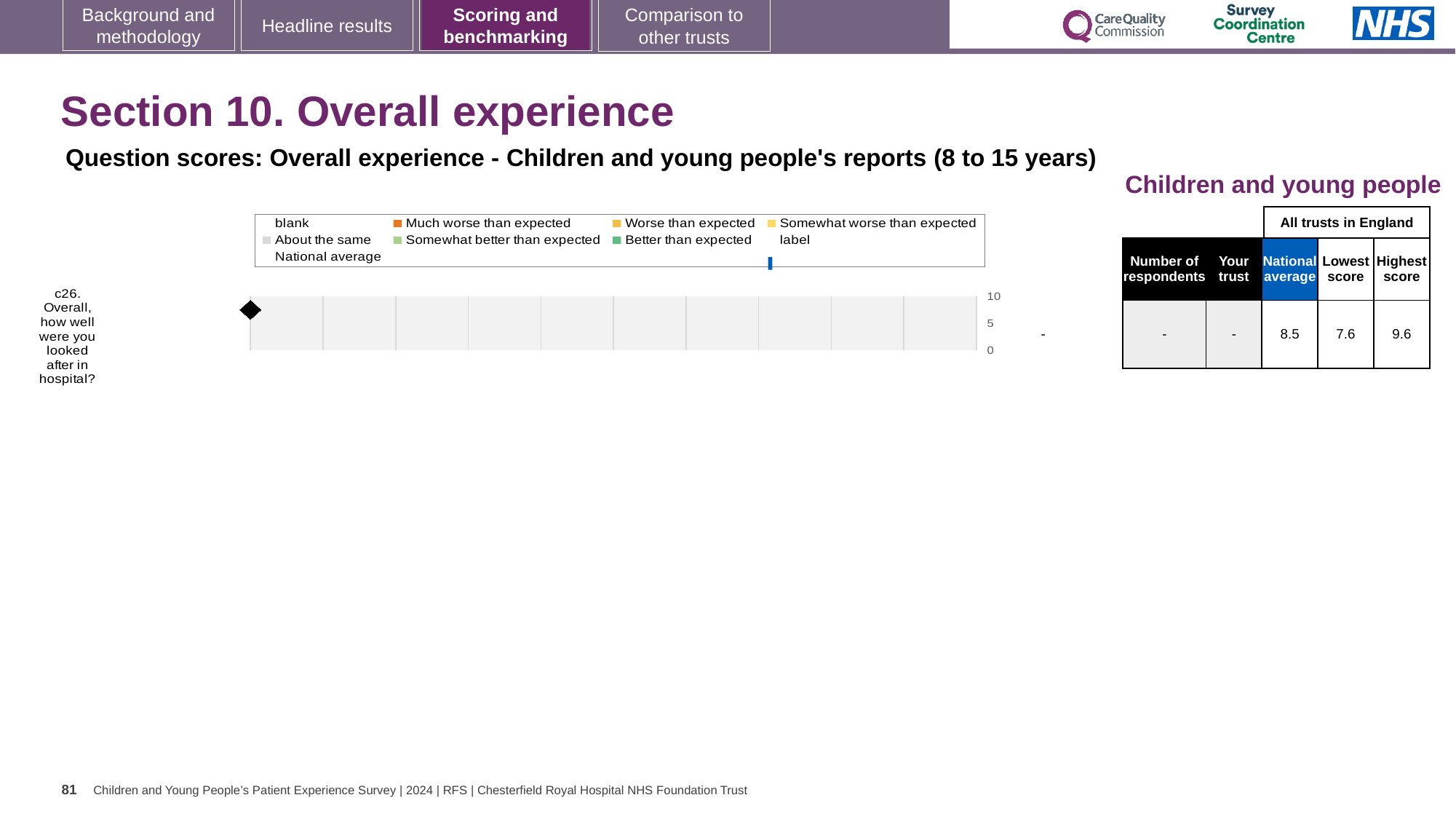
How many survey questions are plotted on the chart? 1 What is the question label shown on the chart? c26. Overall, how well were you looked after in hospital? In the table next to the chart, what value is shown for 'Your trust' for c26? - In the table next to the chart, what is the difference between the Highest score and the Lowest score for c26? 2.0 What is the highest value shown on the chart's score axis? 10 In the table next to the chart, what is the Highest score for c26? 9.6 In the table next to the chart, what is the National average score for c26? 8.5 What kind of chart is shown for question c26 on this slide? bar chart What colour does the legend use for 'Much worse than expected'? orange In the table next to the chart, what is the Lowest score for c26? 7.6 Is the National average score for c26 greater or less than 5? greater In the table next to the chart, which is larger for c26: the National average or the Lowest score? National average